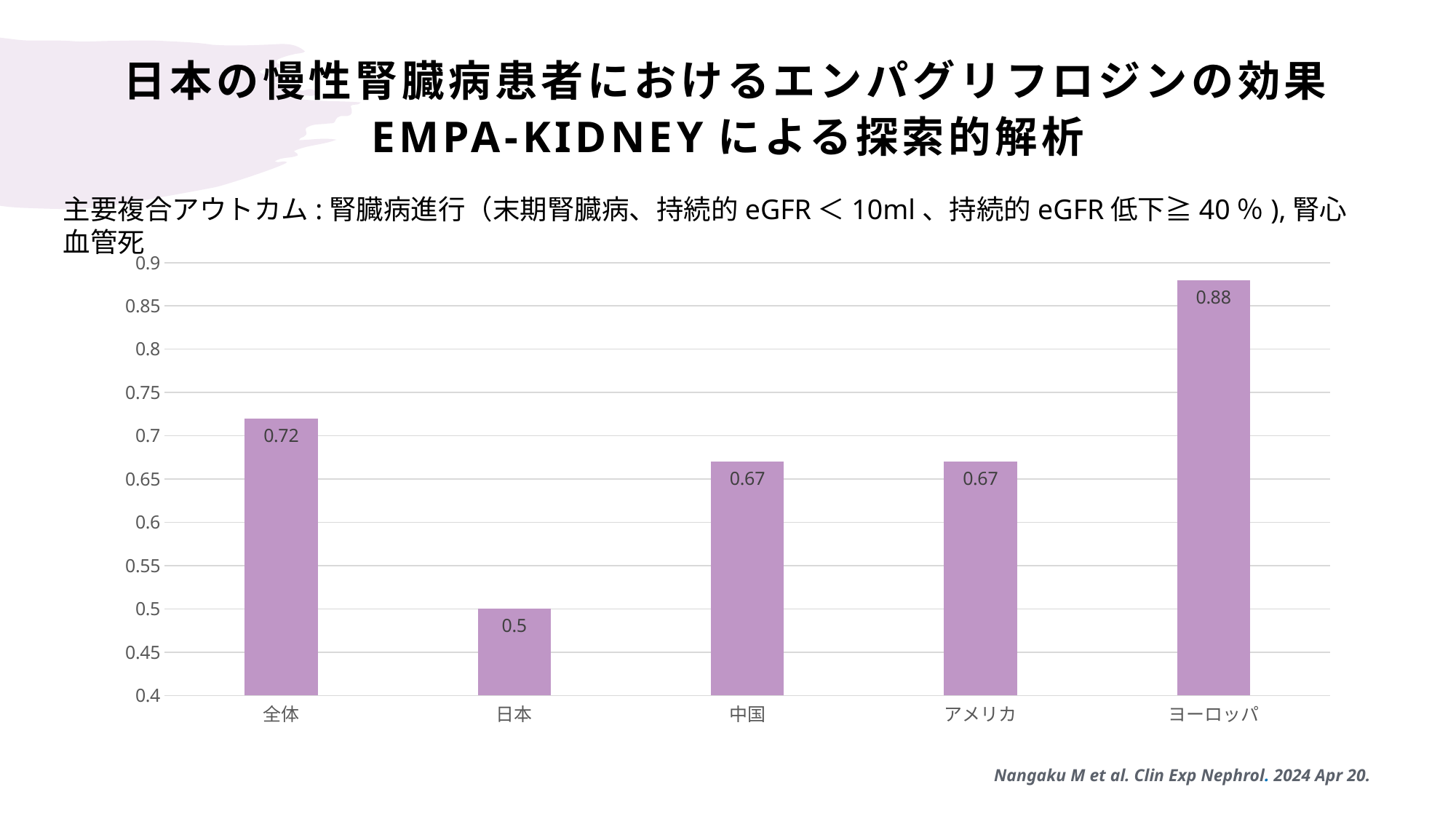
Is the value for アメリカ greater or less than 0.7? less Which category has the lowest value? 日本 What is the value for ヨーロッパ? 0.88 How many categories are shown on the x axis? 5 What is the difference between the values for ヨーロッパ and 日本? 0.38 What is the value for 全体? 0.72 Which is larger, the value for 全体 or the value for 中国? 全体 What is the value for 中国? 0.67 What kind of chart is shown on the slide? bar chart What is the difference between the values for 全体 and アメリカ? 0.05 Which category has the highest value? ヨーロッパ What is the value for 日本? 0.5